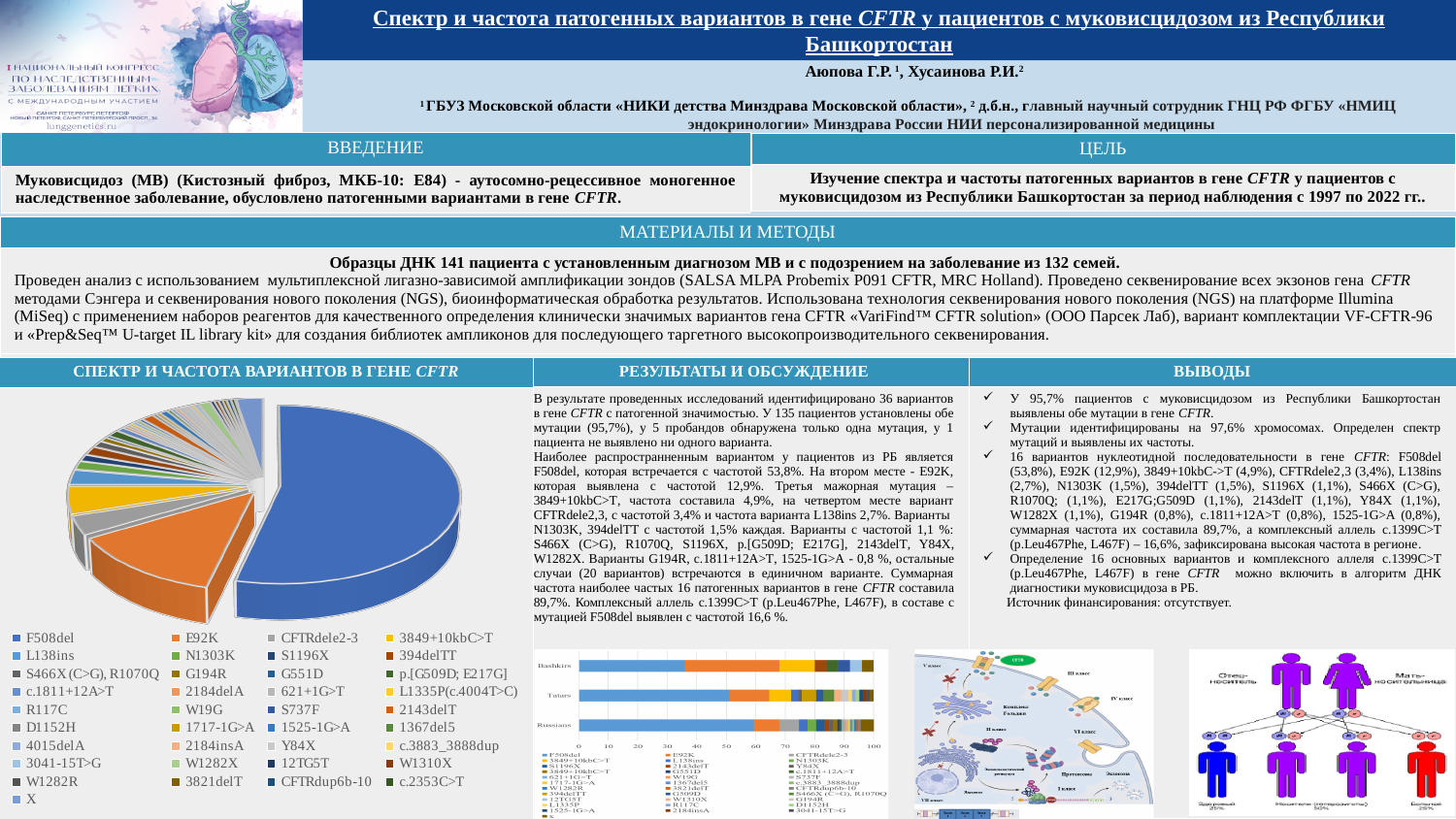
What kind of chart is the small chart at the bottom of the slide showing Bashkirs, Tatars and Russians? Bar chart In the pie chart 'СПЕКТР И ЧАСТОТА ВАРИАНТОВ В ГЕНЕ CFTR', which slice is larger: E92K or 3849+10kbC>T? E92K In the pie chart 'СПЕКТР И ЧАСТОТА ВАРИАНТОВ В ГЕНЕ CFTR', which variant has the largest slice? F508del What kind of chart is shown under the heading 'СПЕКТР И ЧАСТОТА ВАРИАНТОВ В ГЕНЕ CFTR'? Pie chart In the small bar chart at the bottom of the slide, how many population groups are shown on the vertical axis? 3 In the pie chart 'СПЕКТР И ЧАСТОТА ВАРИАНТОВ В ГЕНЕ CFTR', what colour is the E92K slice? Orange In the pie chart 'СПЕКТР И ЧАСТОТА ВАРИАНТОВ В ГЕНЕ CFTR', which slice is larger: F508del or E92K? F508del In the pie chart 'СПЕКТР И ЧАСТОТА ВАРИАНТОВ В ГЕНЕ CFTR', what colour is the F508del slice? Blue